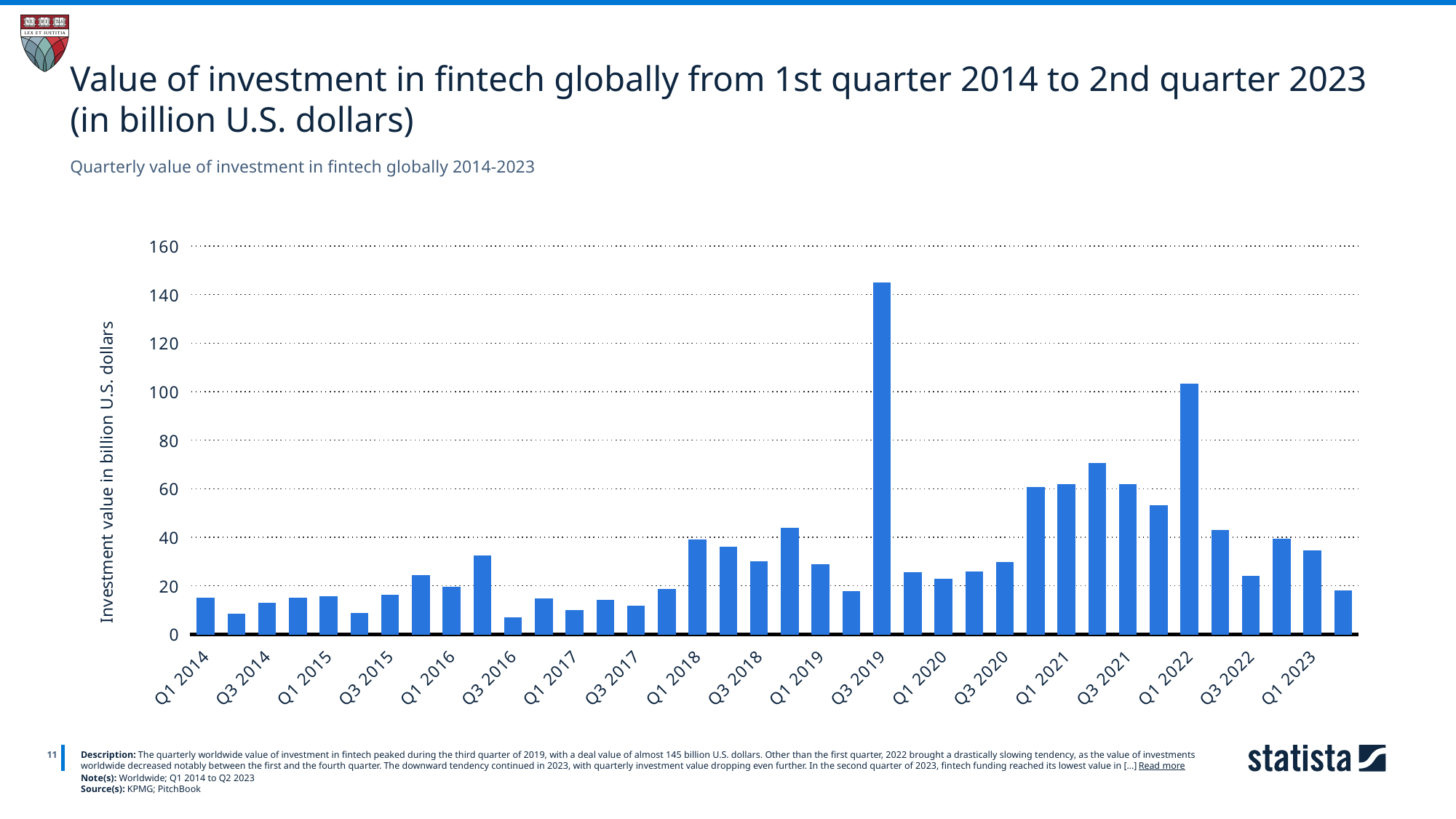
Which quarter has the highest value of fintech investment? Q3 2019 Is the value for Q3 2016 greater or less than 20? less How many quarterly bars are plotted in the chart? 38 What kind of chart is shown on the slide? bar chart Which is larger, the value for Q3 2019 or the value for Q1 2022? Q3 2019 Is the value for Q3 2019 greater or less than 120? greater Is the value for Q1 2022 greater or less than 80? greater Which is larger, the value for Q1 2020 or the value for Q1 2021? Q1 2021 What is the label of the vertical axis? Investment value in billion U.S. dollars Do the values rise or fall from Q1 2020 to Q1 2021? rise